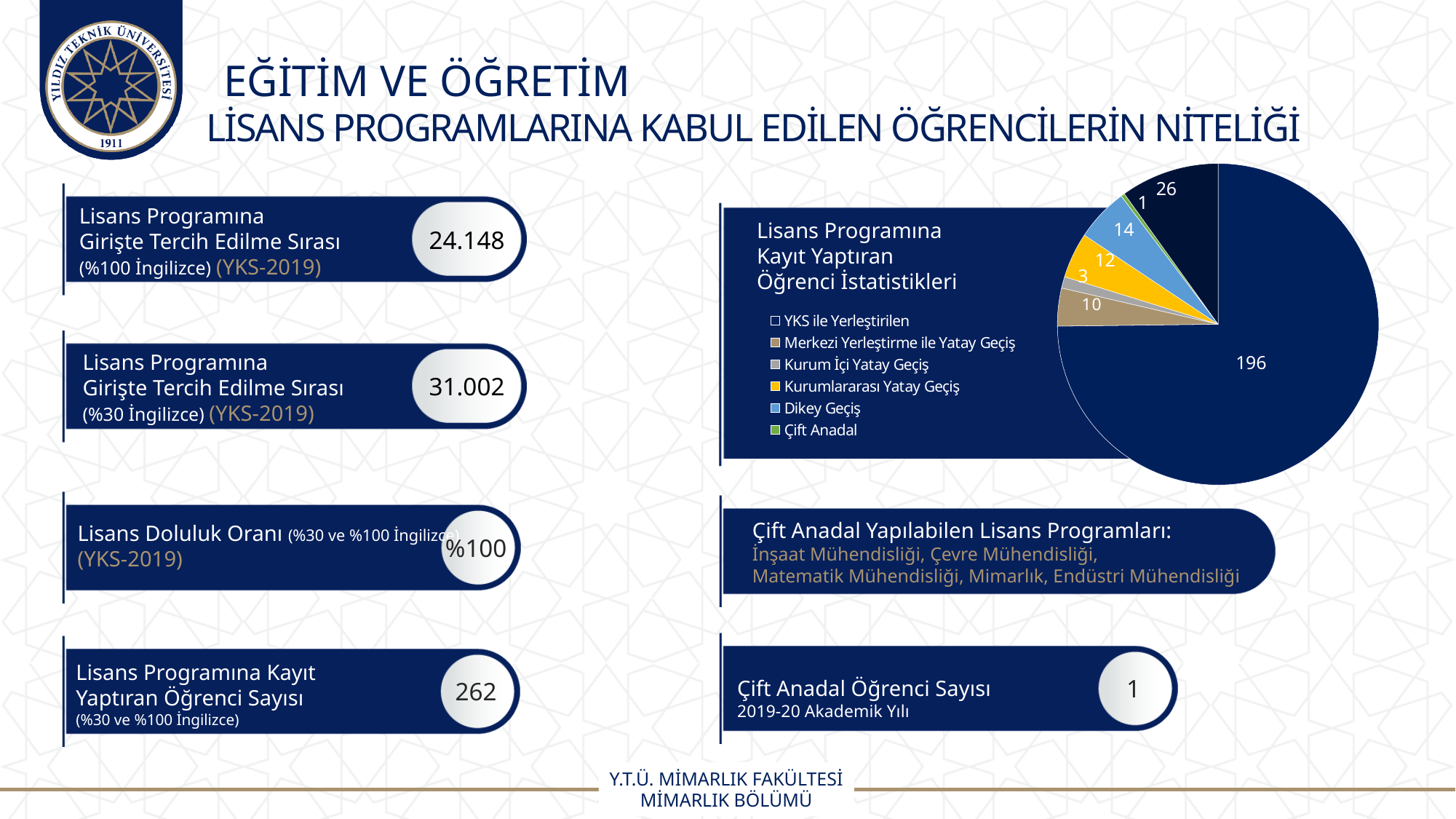
In the pie chart, what is the value for Kurumlararası Yatay Geçiş? 12 What is the title of the pie chart? Lisans Programına Kayıt Yaptıran Öğrenci İstatistikleri In the pie chart, what is the value for Merkezi Yerleştirme ile Yatay Geçiş? 10 In the pie chart, what is the difference between the values for Dikey Geçiş and Kurumlararası Yatay Geçiş? 2 In the pie chart, which is larger: Merkezi Yerleştirme ile Yatay Geçiş or Kurum İçi Yatay Geçiş? Merkezi Yerleştirme ile Yatay Geçiş In the pie chart, what is the value for Çift Anadal? 1 How many entries does the legend of the pie chart list? 6 Which category has the smallest slice in the pie chart? Çift Anadal What type of chart is shown on the right side of the slide? pie chart In the pie chart, what is the value for Kurum İçi Yatay Geçiş? 3 Which category has the largest slice in the pie chart? YKS ile Yerleştirilen In the pie chart, what is the value for Dikey Geçiş? 14